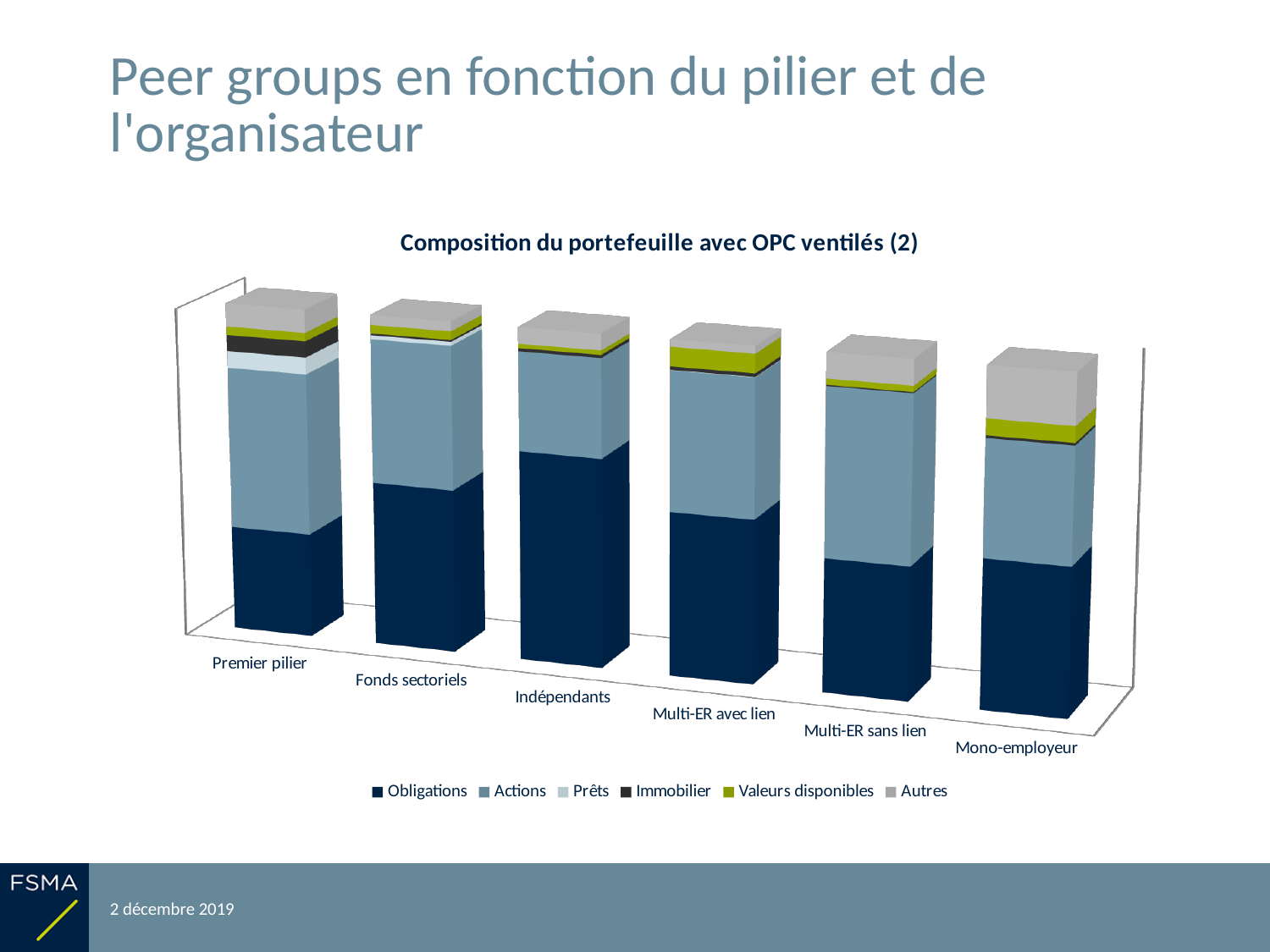
Is the Autres segment larger for Mono-employeur or for Indépendants? Mono-employeur What is the title of the chart? Composition du portefeuille avec OPC ventilés (2) Which category has the largest Autres segment? Mono-employeur How many categories (peer groups) are shown on the x axis of the chart? 6 Which category has the smallest Obligations segment? Premier pilier Which series is listed first in the chart legend? Obligations How many series does the chart legend list? 6 Is the Valeurs disponibles segment larger for Multi-ER avec lien or for Indépendants? Multi-ER avec lien Is the Obligations segment larger for Mono-employeur or for Premier pilier? Mono-employeur What kind of chart is shown on the slide? Stacked bar chart